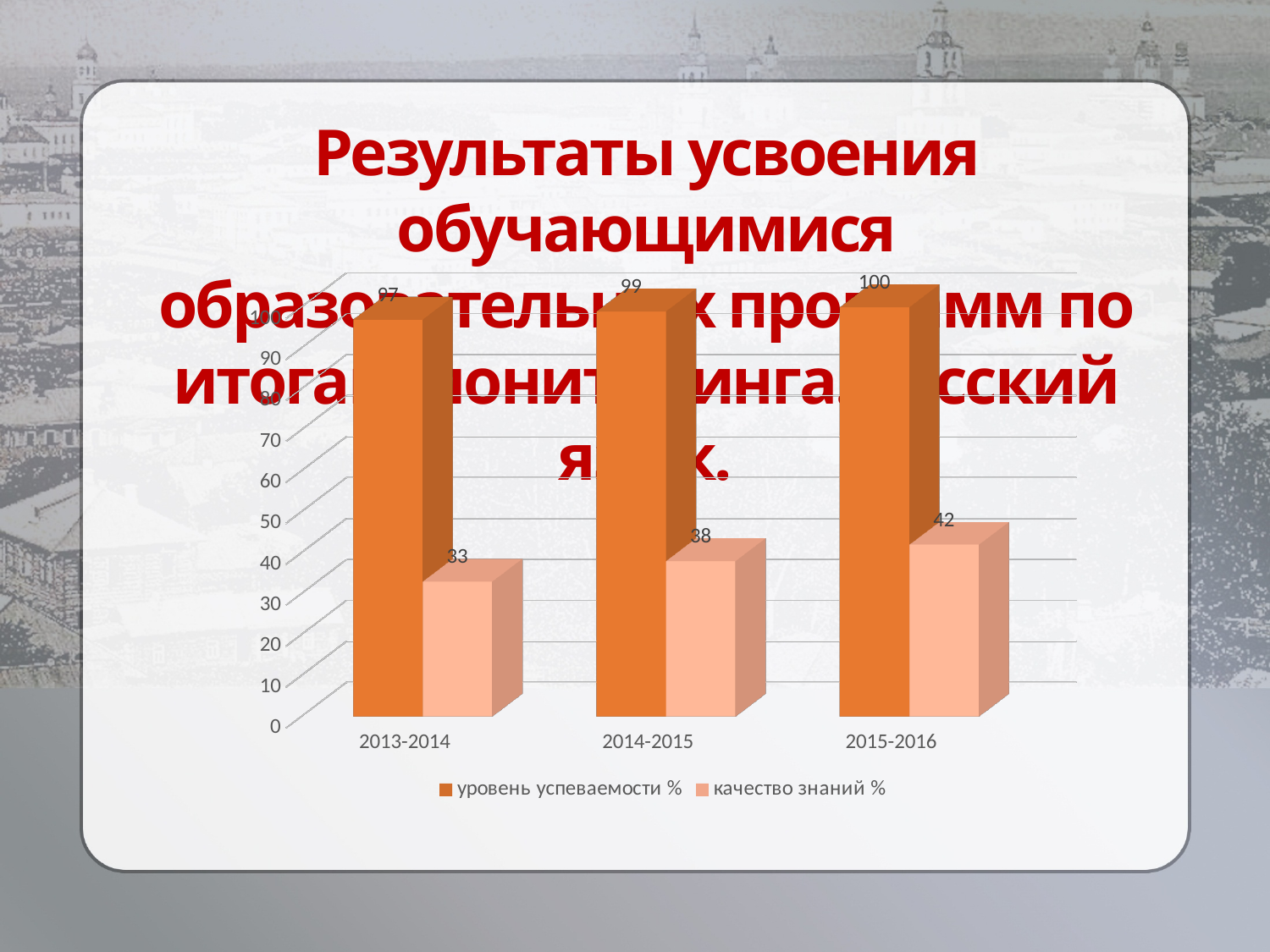
How many series does the legend list? 2 What is the value of качество знаний % for 2014-2015? 38 How many year categories are shown on the x axis? 3 Which is larger: качество знаний % in 2014-2015 or in 2015-2016? 2015-2016 Which year has the highest value for уровень успеваемости %? 2015-2016 What is the value of качество знаний % for 2015-2016? 42 Which year has the lowest value for качество знаний %? 2013-2014 What is the difference between уровень успеваемости % and качество знаний % in 2013-2014? 64 Does качество знаний % rise or fall from 2013-2014 to 2015-2016? Rise What kind of chart is shown on the slide? Bar chart What is the value of уровень успеваемости % for 2013-2014? 97 By how much did качество знаний % increase from 2013-2014 to 2015-2016? 9